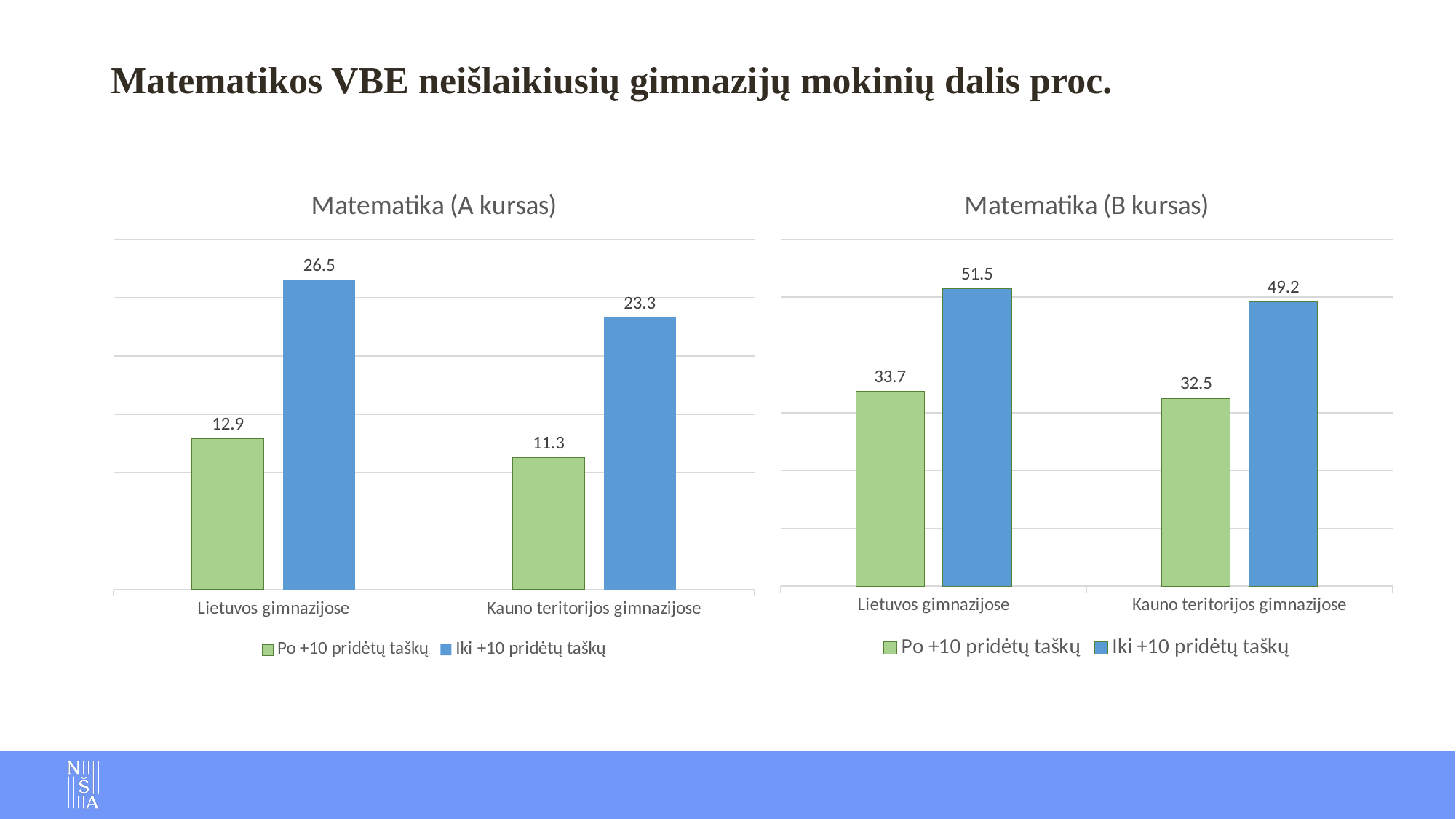
In the 'Matematika (B kursas)' chart, which is larger: 'Po +10 pridėtų taškų' for Lietuvos gimnazijose or for Kauno teritorijos gimnazijose? Lietuvos gimnazijose In the 'Matematika (A kursas)' chart, which bar has the highest value? Iki +10 pridėtų taškų, Lietuvos gimnazijose How many series does the legend of the 'Matematika (B kursas)' chart list? 2 In the 'Matematika (B kursas)' chart, which bar has the lowest value? Po +10 pridėtų taškų, Kauno teritorijos gimnazijose In the 'Matematika (B kursas)' chart, what is the value for 'Iki +10 pridėtų taškų' in Lietuvos gimnazijose? 51.5 In the 'Matematika (B kursas)' chart, what is the value for 'Po +10 pridėtų taškų' in Kauno teritorijos gimnazijose? 32.5 How many categories are shown on the x axis of the 'Matematika (A kursas)' chart? 2 In the 'Matematika (A kursas)' chart, what is the value for 'Po +10 pridėtų taškų' in Kauno teritorijos gimnazijose? 11.3 In the 'Matematika (B kursas)' chart, what is the difference between 'Iki +10 pridėtų taškų' for Lietuvos gimnazijose and for Kauno teritorijos gimnazijose? 2.3 In the 'Matematika (A kursas)' chart, what is the difference between 'Iki +10 pridėtų taškų' and 'Po +10 pridėtų taškų' for Lietuvos gimnazijose? 13.6 What kind of chart is 'Matematika (A kursas)'? Bar chart In the 'Matematika (A kursas)' chart, what is the value for 'Iki +10 pridėtų taškų' in Lietuvos gimnazijose? 26.5